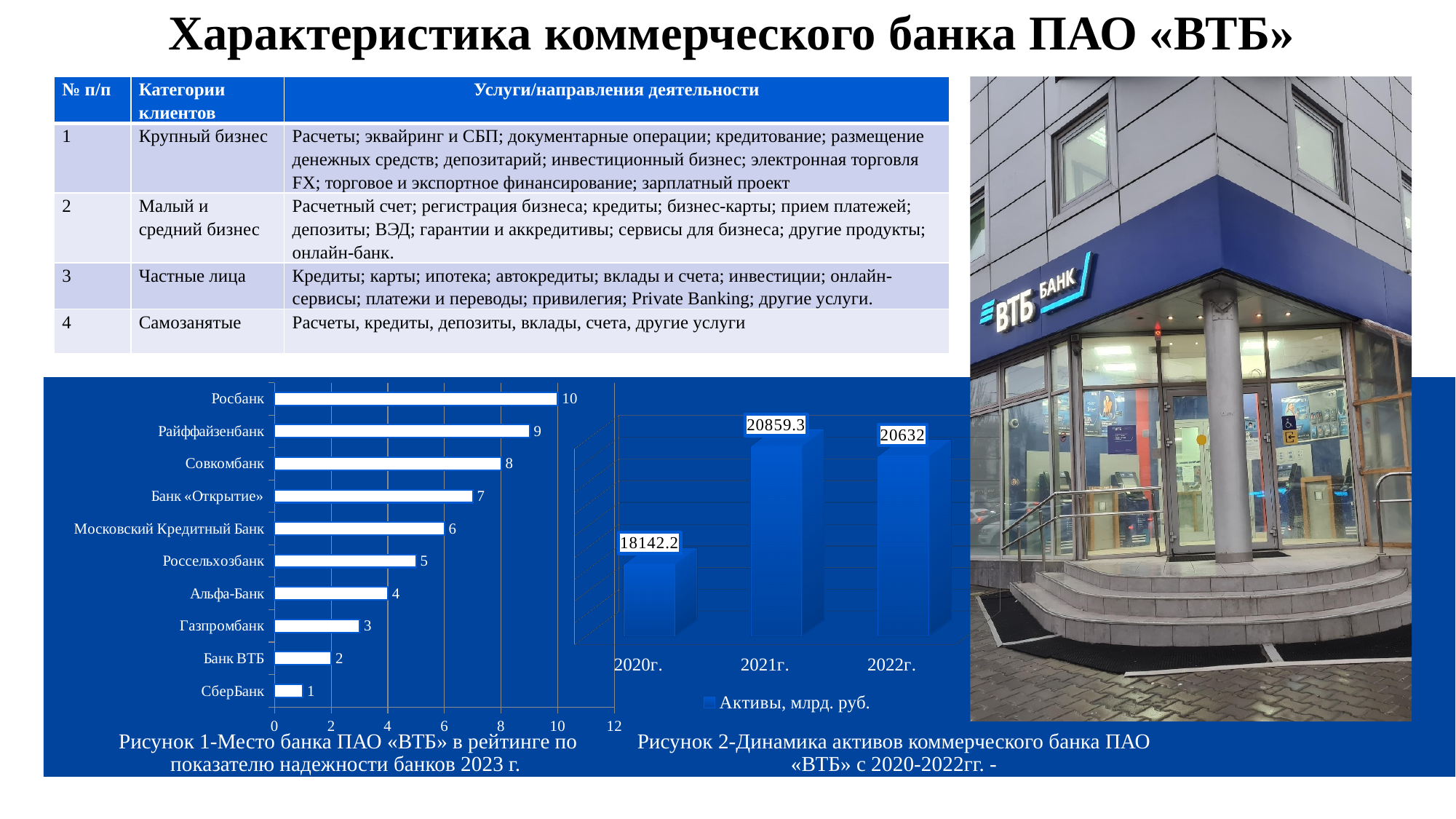
In the left chart (Рисунок 1), what is the value for Банк ВТБ? 2 In the left chart (Рисунок 1), which bank has the lowest value? СберБанк In the left chart (Рисунок 1), which bank has the highest value? Росбанк What kind of chart is the left chart (Рисунок 1)? Bar chart In the right chart (Рисунок 2), what series does the legend list? Активы, млрд. руб. In the left chart (Рисунок 1), how many banks are listed? 10 In the right chart (Рисунок 2), which year has the highest assets? 2021г. In the right chart (Рисунок 2), which is larger: the value for 2022г. or the value for 2020г.? 2022г. In the left chart (Рисунок 1), what is the value for Росбанк? 10 In the right chart (Рисунок 2), what is the value of assets for 2020г.? 18142.2 In the left chart (Рисунок 1), what is the difference between the values for Газпромбанк and Альфа-Банк? 1 In the right chart (Рисунок 2), what is the value of assets for 2021г.? 20859.3